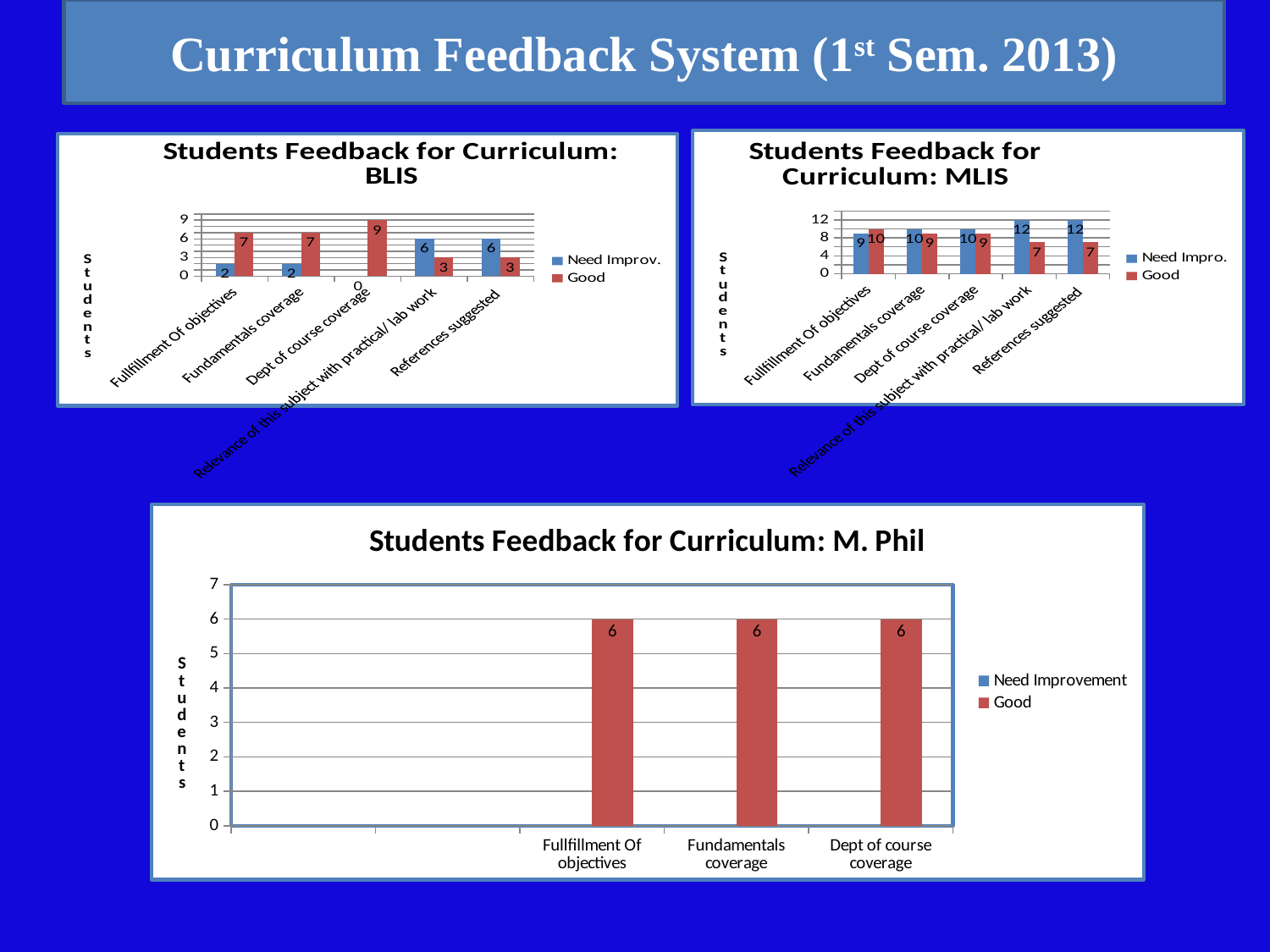
In the 'Students Feedback for Curriculum: MLIS' chart, which category has the lowest Good value? Relevance of this subject with practical/lab work and References suggested (both 7) In the 'Students Feedback for Curriculum: BLIS' chart, what is the Good value for Dept of course coverage? 9 How many series does the legend of the 'Students Feedback for Curriculum: M. Phil' chart list? 2 In the 'Students Feedback for Curriculum: BLIS' chart, what is the Need Improv. value for References suggested? 6 In the 'Students Feedback for Curriculum: MLIS' chart, what is the Good value for Fulfillment Of objectives? 10 How many categories are shown on the x axis of the 'Students Feedback for Curriculum: M. Phil' chart? 3 In the 'Students Feedback for Curriculum: MLIS' chart, what is the Need Impro. value for Relevance of this subject with practical/lab work? 12 In the 'Students Feedback for Curriculum: MLIS' chart, is the Need Impro. value for Fundamentals coverage larger or smaller than its Good value? larger In the 'Students Feedback for Curriculum: M. Phil' chart, what is the Good value for Fundamentals coverage? 6 What type of chart is the 'Students Feedback for Curriculum: BLIS' chart? Bar chart In the 'Students Feedback for Curriculum: BLIS' chart, which category has the highest Good value? Dept of course coverage In the 'Students Feedback for Curriculum: BLIS' chart, what is the difference between the Good and Need Improv. values for Fulfillment Of objectives? 5